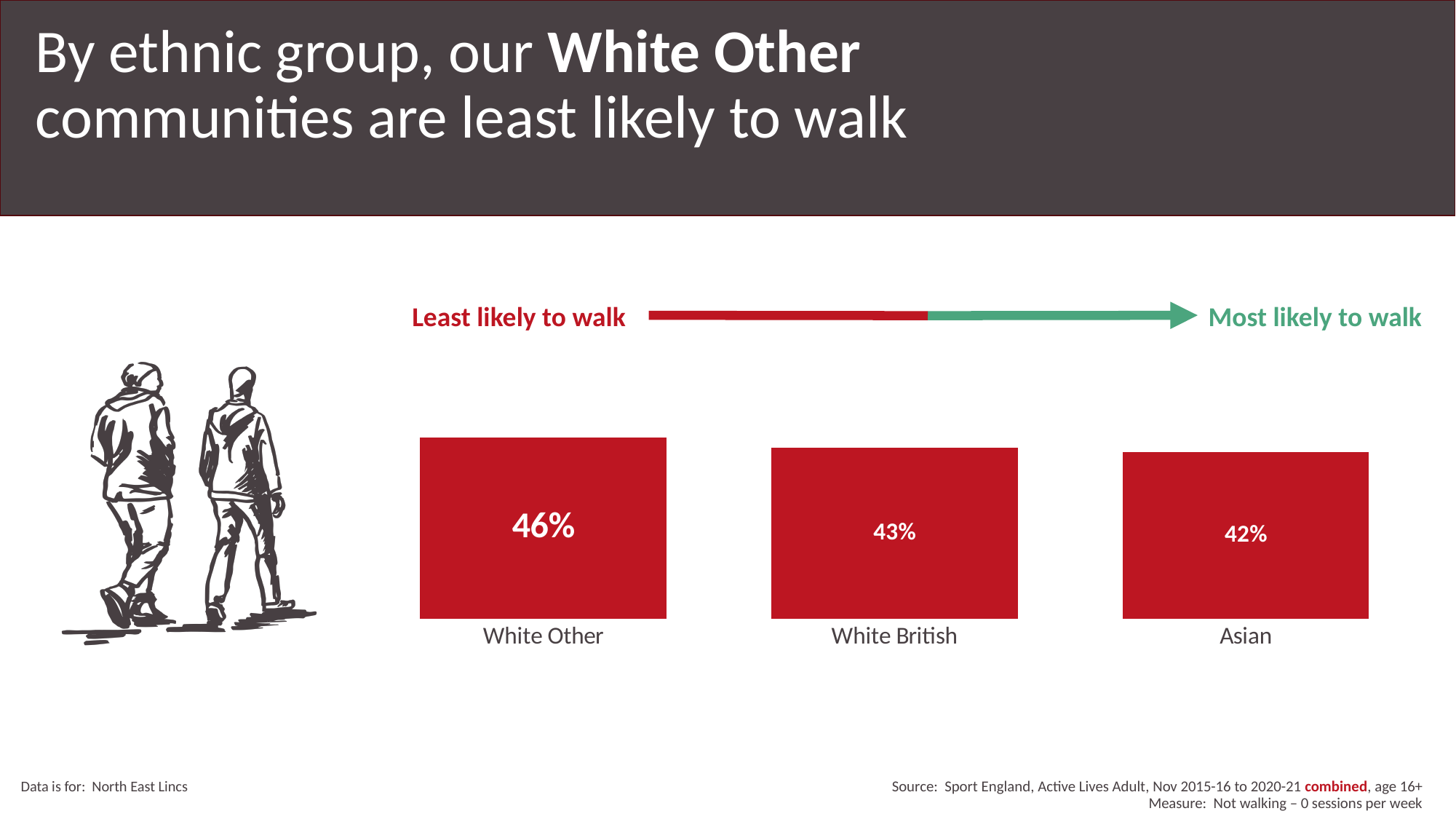
What is the value for White Other? 46% What is the value for White British? 43% What is the value for Asian? 42% What label appears at the right end of the arrow above the chart? Most likely to walk How many ethnic groups are shown in the chart? 3 Do the values rise or fall from left to right across the chart? Fall Which ethnic group has the lowest value? Asian What is the difference between the values for White Other and White British? 3% What is the difference between the values for White Other and Asian? 4% What kind of chart is shown on the slide? Bar chart Which is larger, the value for White British or the value for Asian? White British Which ethnic group has the highest value? White Other